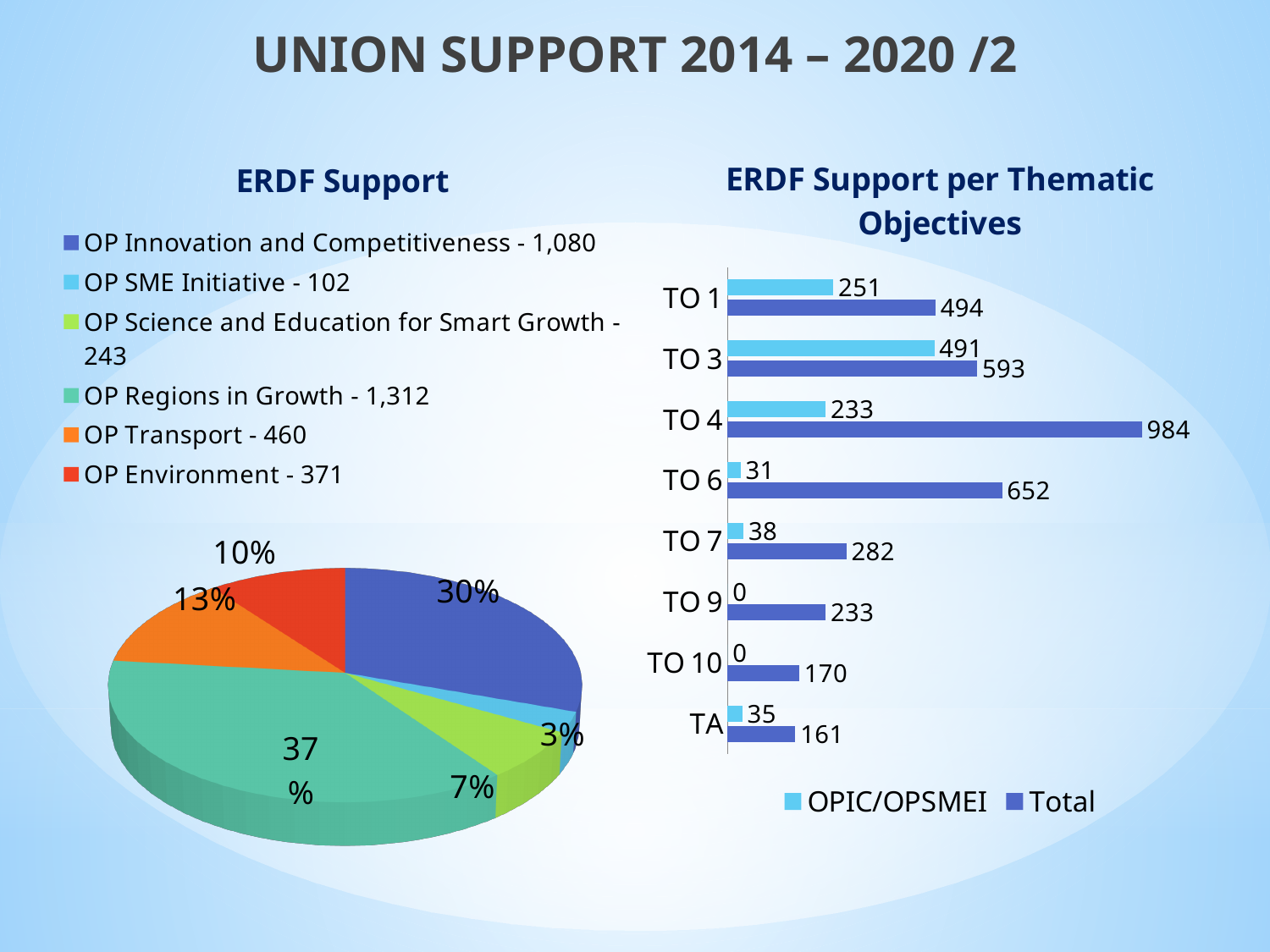
In the 'ERDF Support per Thematic Objectives' chart, which is larger: the Total for TO 6 or the Total for TO 3? Total for TO 6 In the 'ERDF Support' pie chart, what value is listed for OP Transport in the legend? 460 How many series does the legend of the 'ERDF Support per Thematic Objectives' chart list? 2 In the 'ERDF Support per Thematic Objectives' chart, what is the difference between the Total and OPIC/OPSMEI values for TO 1? 243 What kind of chart is 'ERDF Support per Thematic Objectives'? Bar chart In the 'ERDF Support per Thematic Objectives' chart, what is the Total value for TO 4? 984 In the 'ERDF Support' pie chart, which operational programme has the smallest slice? OP SME Initiative In the 'ERDF Support' pie chart, what share does OP Regions in Growth have? 37% How many thematic objective categories are shown in the 'ERDF Support per Thematic Objectives' chart? 8 In the 'ERDF Support per Thematic Objectives' chart, what is the OPIC/OPSMEI value for TO 3? 491 In the 'ERDF Support per Thematic Objectives' chart, which category has the lowest Total value? TA In the 'ERDF Support per Thematic Objectives' chart, which thematic objective has the highest Total value? TO 4